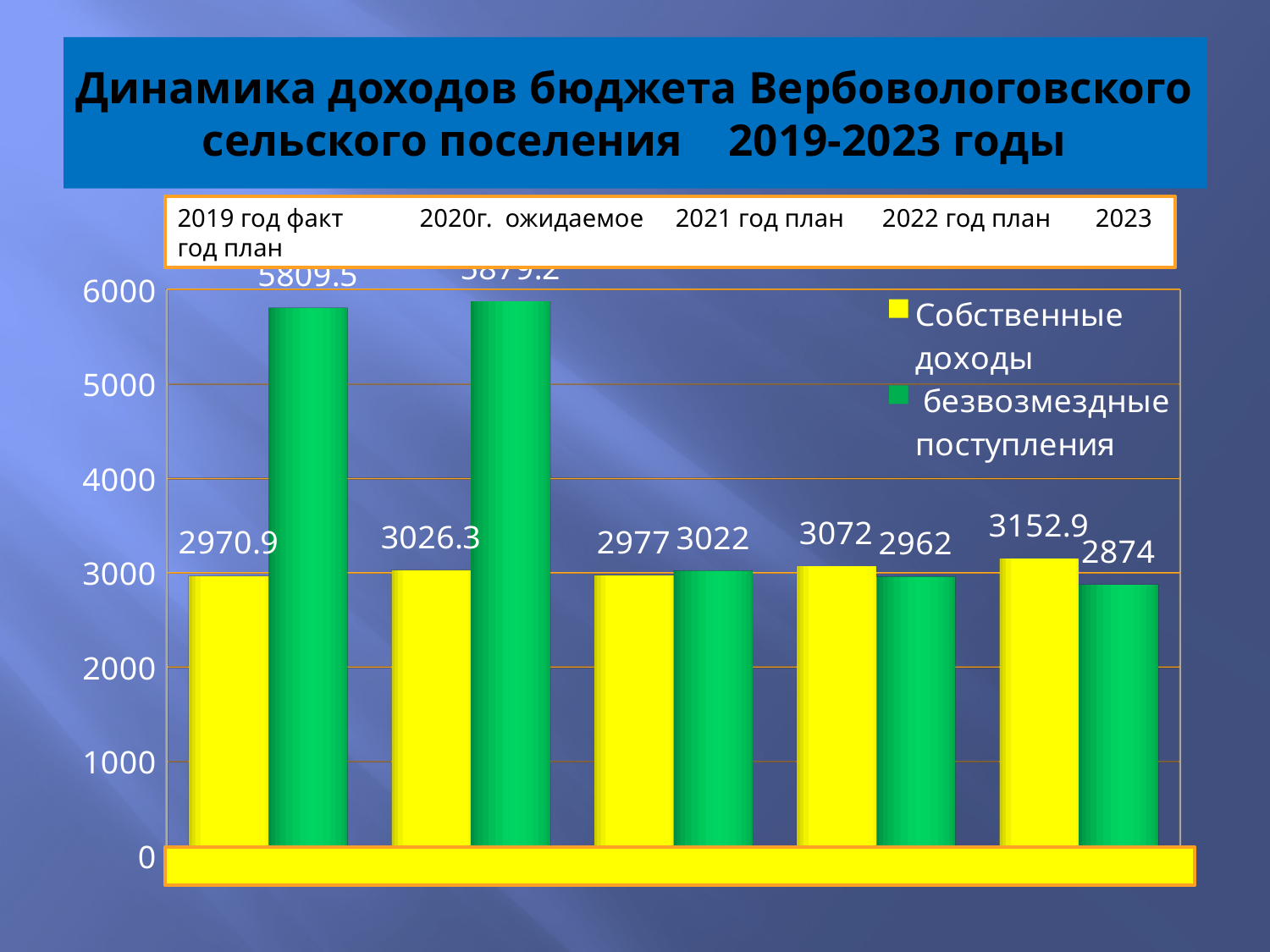
What is the difference between Собственные доходы and безвозмездные поступления for 2022 год план? 110 How many year categories are shown on the chart? 5 In which year is безвозмездные поступления the lowest? 2023 год план For 2021 год план, which is larger: Собственные доходы or безвозмездные поступления? безвозмездные поступления Do the values of Собственные доходы rise or fall from 2021 год план to 2023 год план? rise In which year is Собственные доходы the highest? 2023 год план What is the value of безвозмездные поступления for 2019 год факт? 5809.5 How many series does the legend list? 2 What is the value of Собственные доходы for 2023 год план? 3152.9 What is the value of безвозмездные поступления for 2023 год план? 2874 What is the value of Собственные доходы for 2019 год факт? 2970.9 Is the value of безвозмездные поступления for 2020г. ожидаемое greater or less than 5000? greater